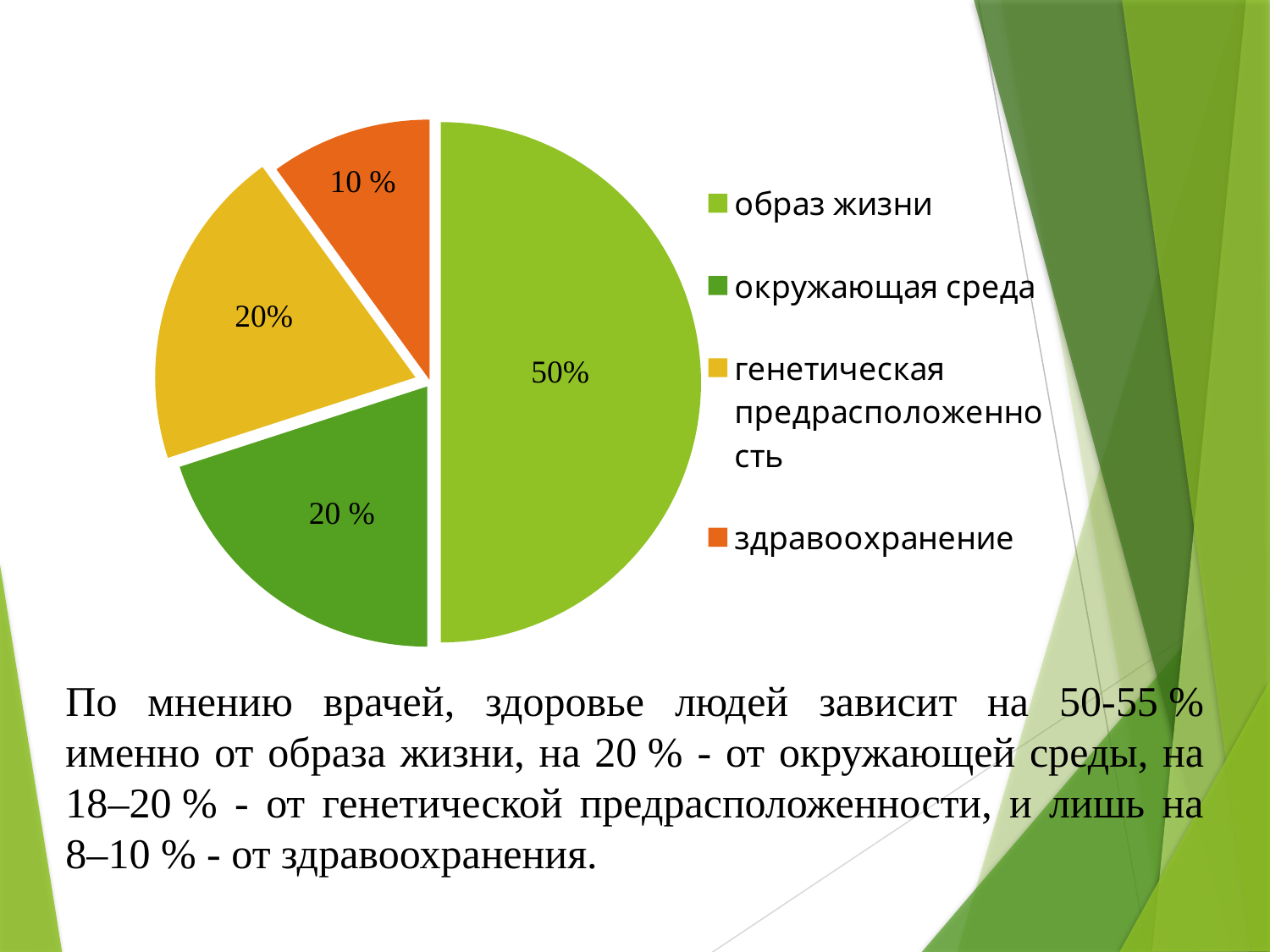
What value is shown for the slice "здравоохранение"? 10 % What colour is the slice for "здравоохранение"? orange How many slices does the pie chart have? 4 What value is shown for the slice "окружающая среда"? 20 % What value is shown for the slice "генетическая предрасположенность"? 20% Which category has the smallest slice of the pie? здравоохранение Which is larger, the slice for "образ жизни" or the slice for "здравоохранение"? образ жизни What value is shown for the slice "образ жизни"? 50% What share of the pie does "образ жизни" take? 50% What kind of chart is shown on the slide? pie chart What is the difference in percentage points between the "образ жизни" slice and the "здравоохранение" slice? 40 Which category has the largest slice of the pie? образ жизни